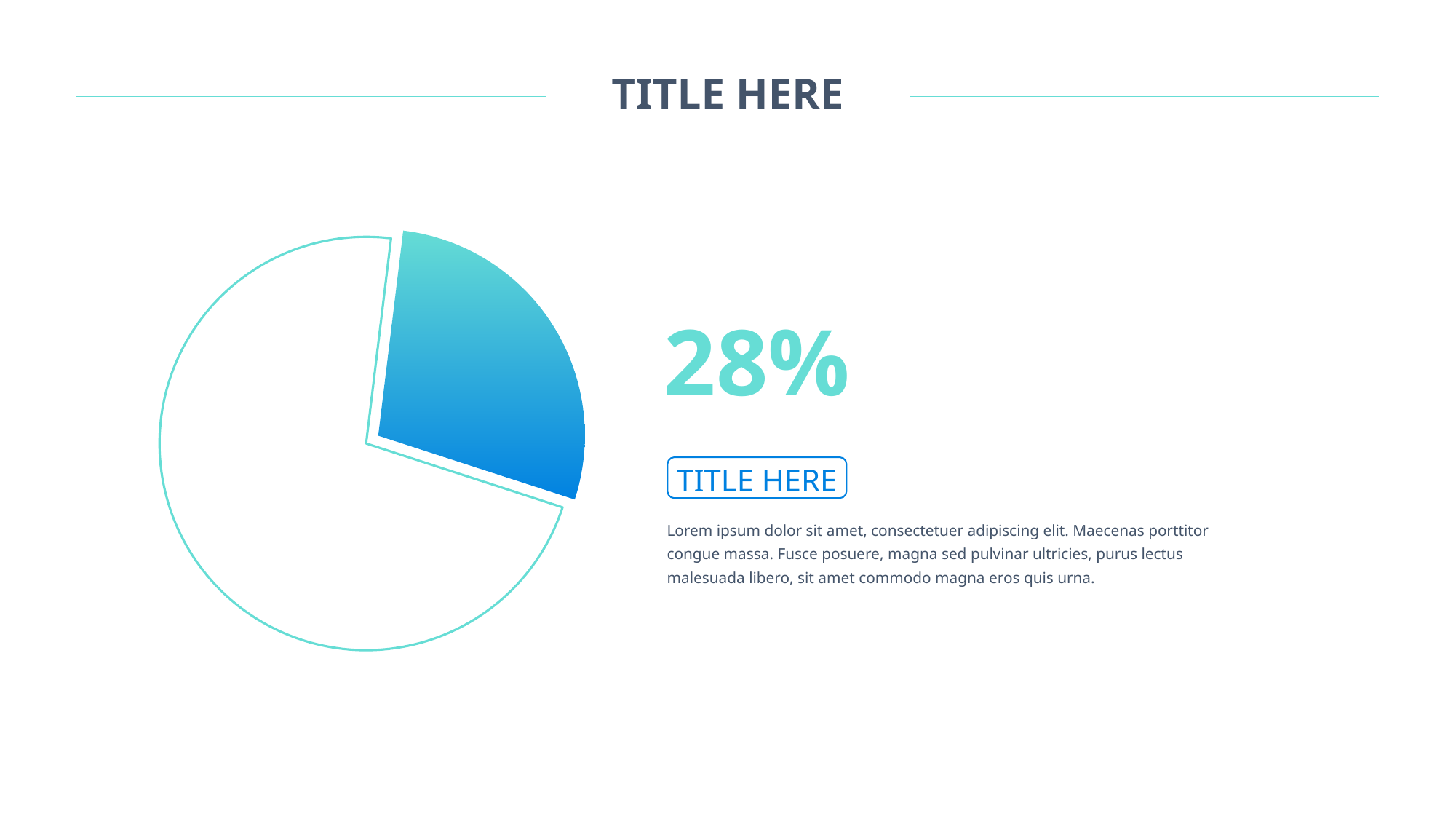
What is the title of the slide? TITLE HERE How many slices does the pie chart have? 2 What kind of chart is shown on the slide? pie chart What percentage is shown for the highlighted (blue) slice of the pie chart? 28% Which slice of the pie chart is larger, the blue highlighted slice or the white slice? the white slice What colour is the highlighted slice of the pie chart? blue What share of the pie does the blue highlighted slice represent? 28% What share of the pie does the white (non-highlighted) portion represent? 72%